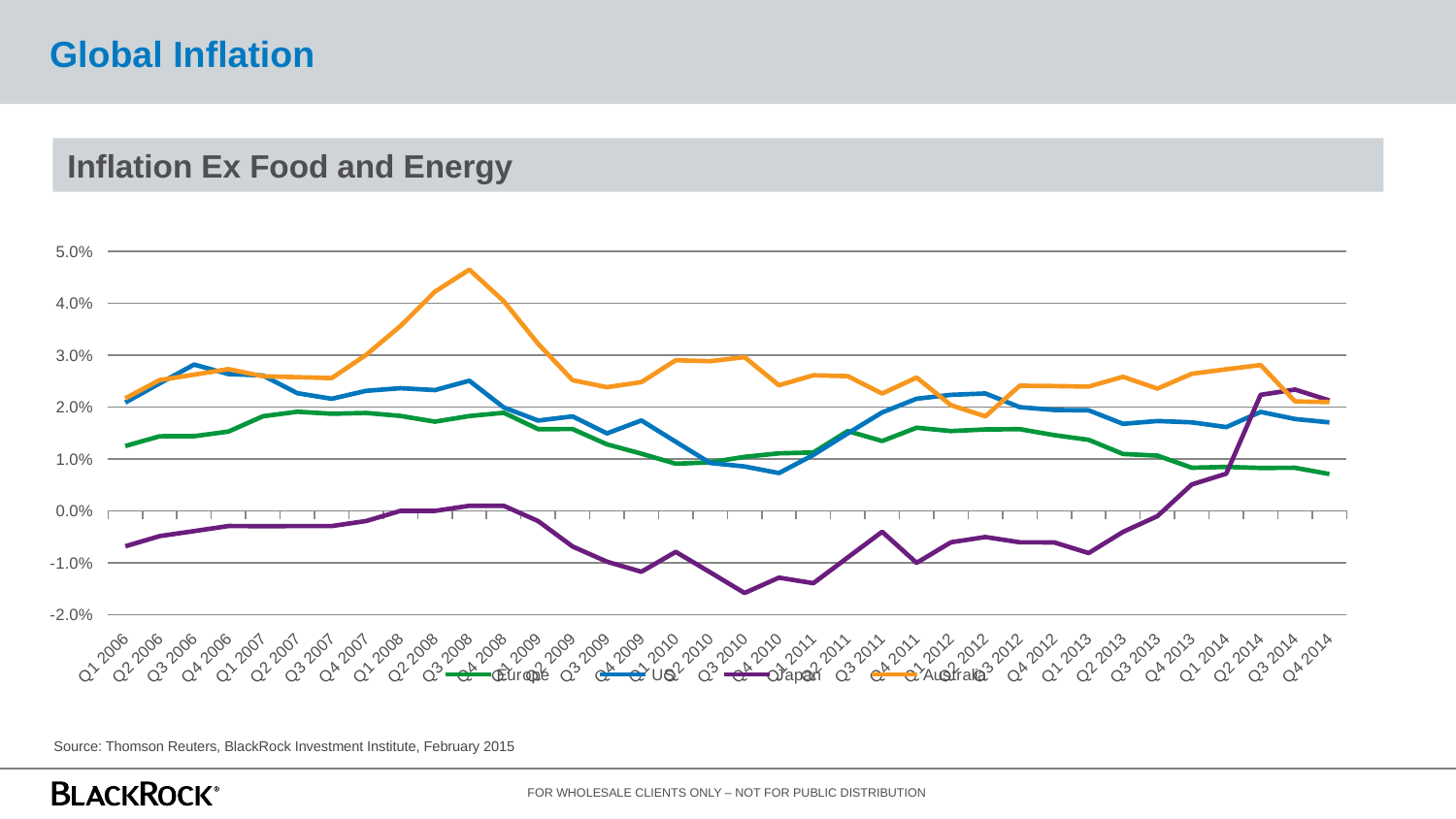
Which series are listed in the chart legend? Europe, US, Japan, Australia Is the value for Japan in Q3 2010 greater or less than -1.0%? less Is the value for US in Q3 2006 greater or less than 2.0%? greater What is the title of the chart? Inflation Ex Food and Energy How many quarterly points are shown on the x axis, from Q1 2006 to Q4 2014? 36 Is the value for Europe in Q4 2014 greater or less than 1.0%? less What kind of chart is shown on the slide? line chart Which series reaches the lowest value anywhere on the chart? Japan In Q1 2006, which is higher, the US line or the Europe line? US Which series reaches the highest value anywhere on the chart? Australia How many series does the legend list? 4